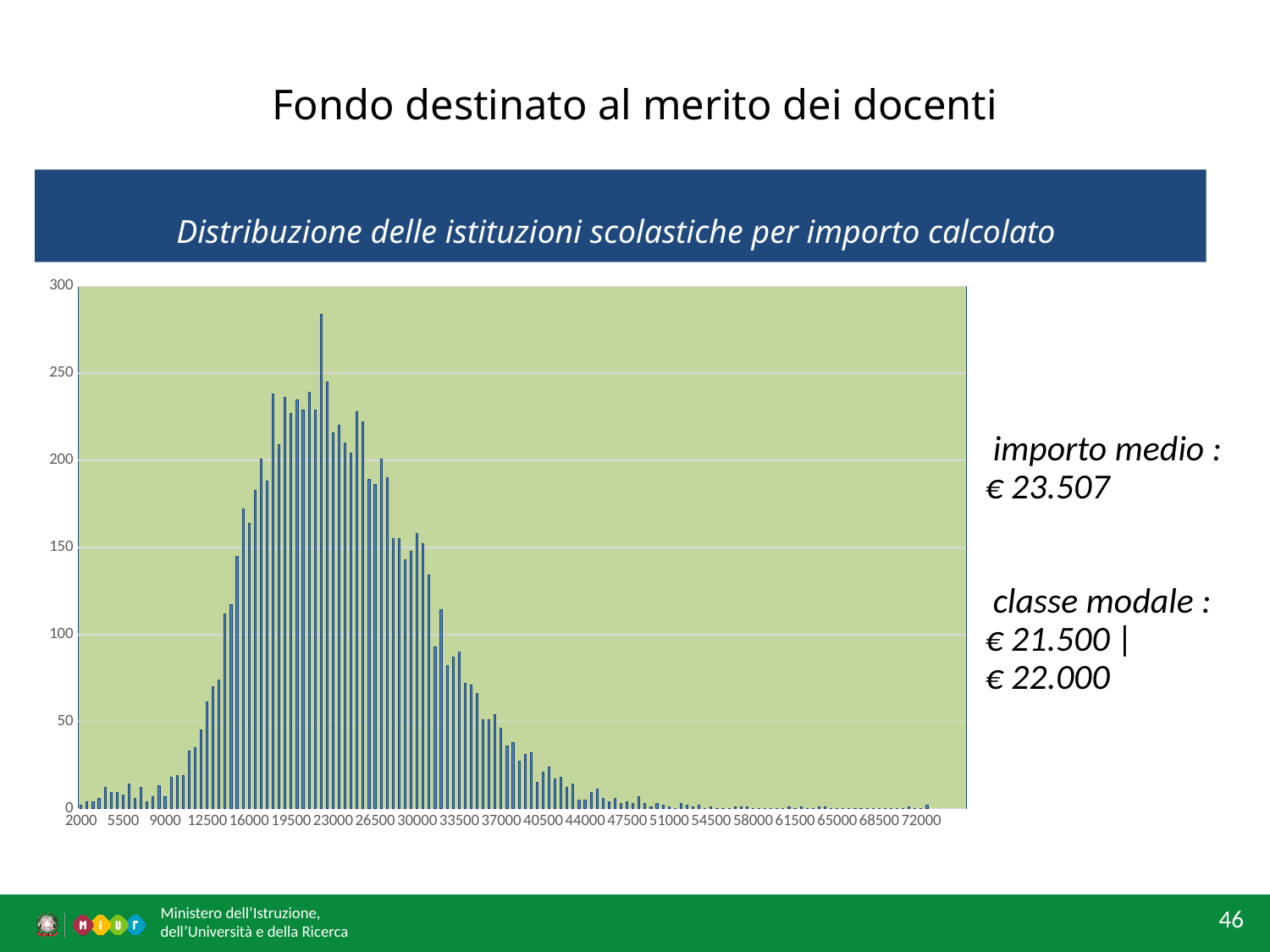
Which class (classe modale) has the highest bar in the chart? € 21.500 | € 22.000 According to the slide, what is the importo medio? € 23.507 Do the values rise or fall along the x axis from 44000 to 72000? fall Is the value for 33500 greater or less than 100? less Is the value for 44000 greater or less than 50? less Is the value for 16000 greater or less than 150? greater Do the values rise or fall along the x axis from 9000 to 19500? rise What is the title of the chart? Distribuzione delle istituzioni scolastiche per importo calcolato What kind of chart is shown on the slide? bar chart